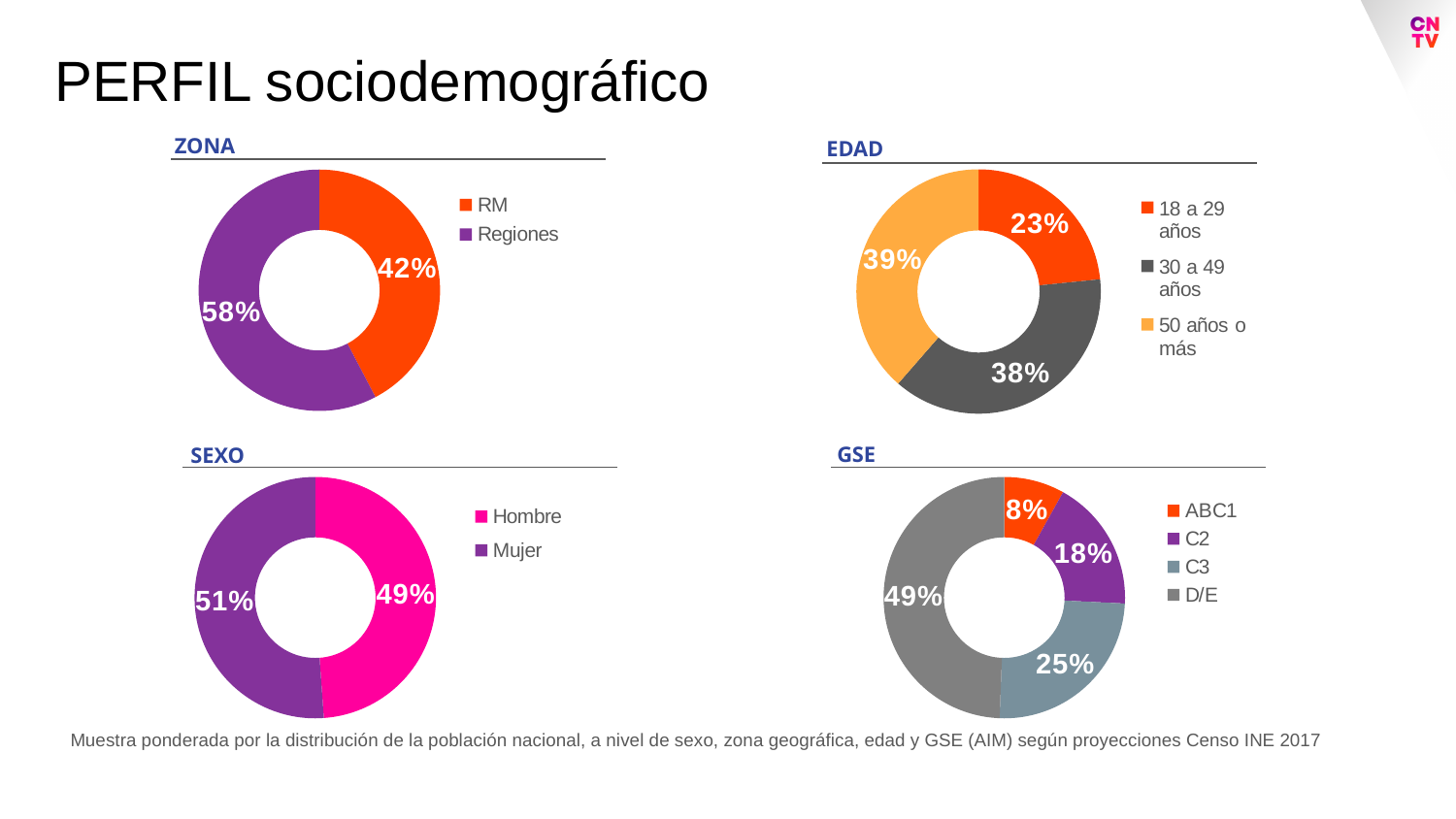
In the GSE chart, which category has the largest share? D/E In the SEXO chart, what share is Mujer? 51% In the GSE chart, what share is C3? 25% What kind of chart is the SEXO chart? Doughnut chart In the GSE chart, which category has the smallest share? ABC1 In the GSE chart, what is the difference in percentage points between D/E and C2? 31 In the ZONA chart, what share is Regiones? 58% In the ZONA chart, what share is RM? 42% In the EDAD chart, what share is 18 a 29 años? 23% In the ZONA chart, which is larger, RM or Regiones? Regiones In the EDAD chart, what share is 50 años o más? 39% How many categories does the EDAD chart show? 3